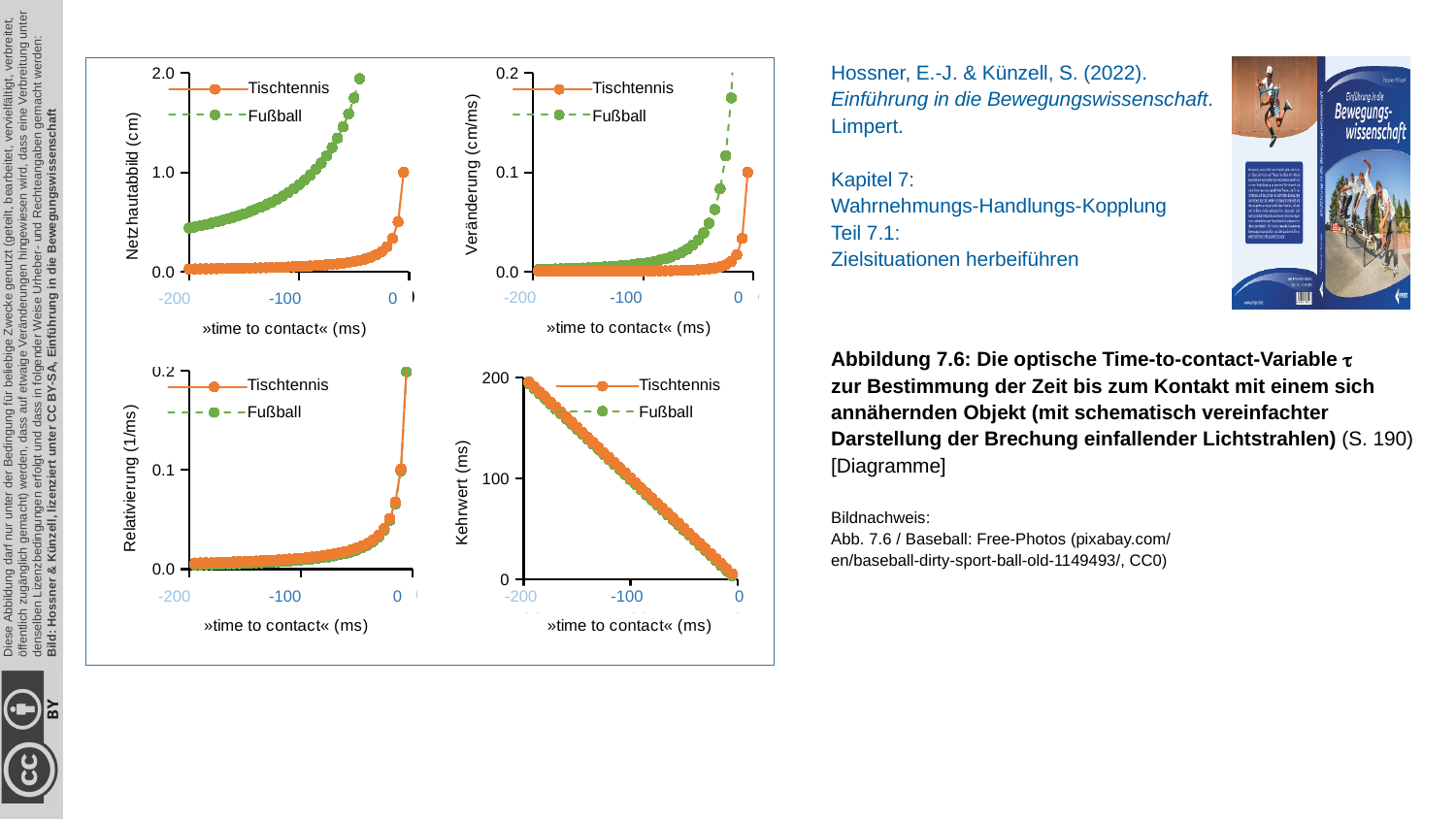
How many series does the legend of the top-left chart (Netzhautabbild) list? 2 In the bottom-right chart (Kehrwert), do the values rise or fall as time to contact goes from -200 to 0 ms? fall In the top-left chart (Netzhautabbild), which series has the larger value at -100 ms, Tischtennis or Fußball? Fußball In the top-left chart (Netzhautabbild), do the values rise or fall as time to contact goes from -200 to 0 ms? rise How many charts are shown on the slide? 4 What are the two series named in the legend of the bottom-left chart (Relativierung)? Tischtennis and Fußball In the top-left chart (Netzhautabbild), is the Fußball value at -200 ms greater or less than 1.0? less In the top-right chart (Veränderung), is the Tischtennis value at -100 ms greater or less than 0.1? less What kind of chart is the top-left chart (Netzhautabbild)? scatter/line chart What is the y-axis label of the bottom-right chart? Kehrwert (ms)